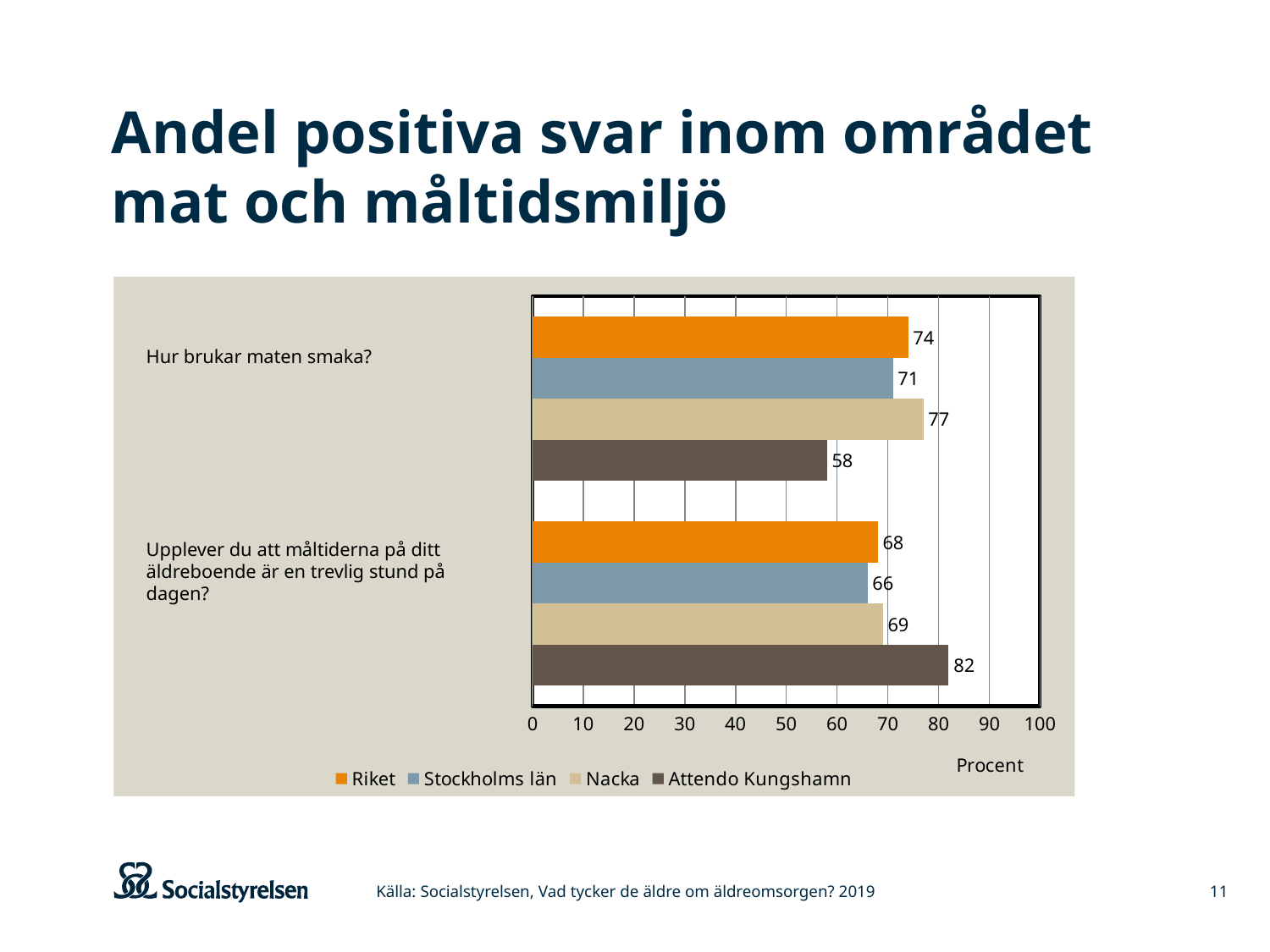
How many series does the legend list? 4 Which series has the highest value for the question "Hur brukar maten smaka?"? Nacka What is the value for Stockholms län for the question "Upplever du att måltiderna på ditt äldreboende är en trevlig stund på dagen?"? 66 Which series has the lowest value for the question "Hur brukar maten smaka?"? Attendo Kungshamn What kind of chart is shown on the slide? Bar chart What is the value for Attendo Kungshamn for the question "Upplever du att måltiderna på ditt äldreboende är en trevlig stund på dagen?"? 82 What is the value for Nacka for the question "Hur brukar maten smaka?"? 77 What is the value for Riket for the question "Hur brukar maten smaka?"? 74 What unit is shown on the x axis of the chart? Procent Which series has the highest value for the question "Upplever du att måltiderna på ditt äldreboende är en trevlig stund på dagen?"? Attendo Kungshamn What is the difference between the Nacka and Attendo Kungshamn values for the question "Hur brukar maten smaka?"? 19 For Attendo Kungshamn, which question has the larger value: "Hur brukar maten smaka?" or "Upplever du att måltiderna på ditt äldreboende är en trevlig stund på dagen?"? Upplever du att måltiderna på ditt äldreboende är en trevlig stund på dagen?